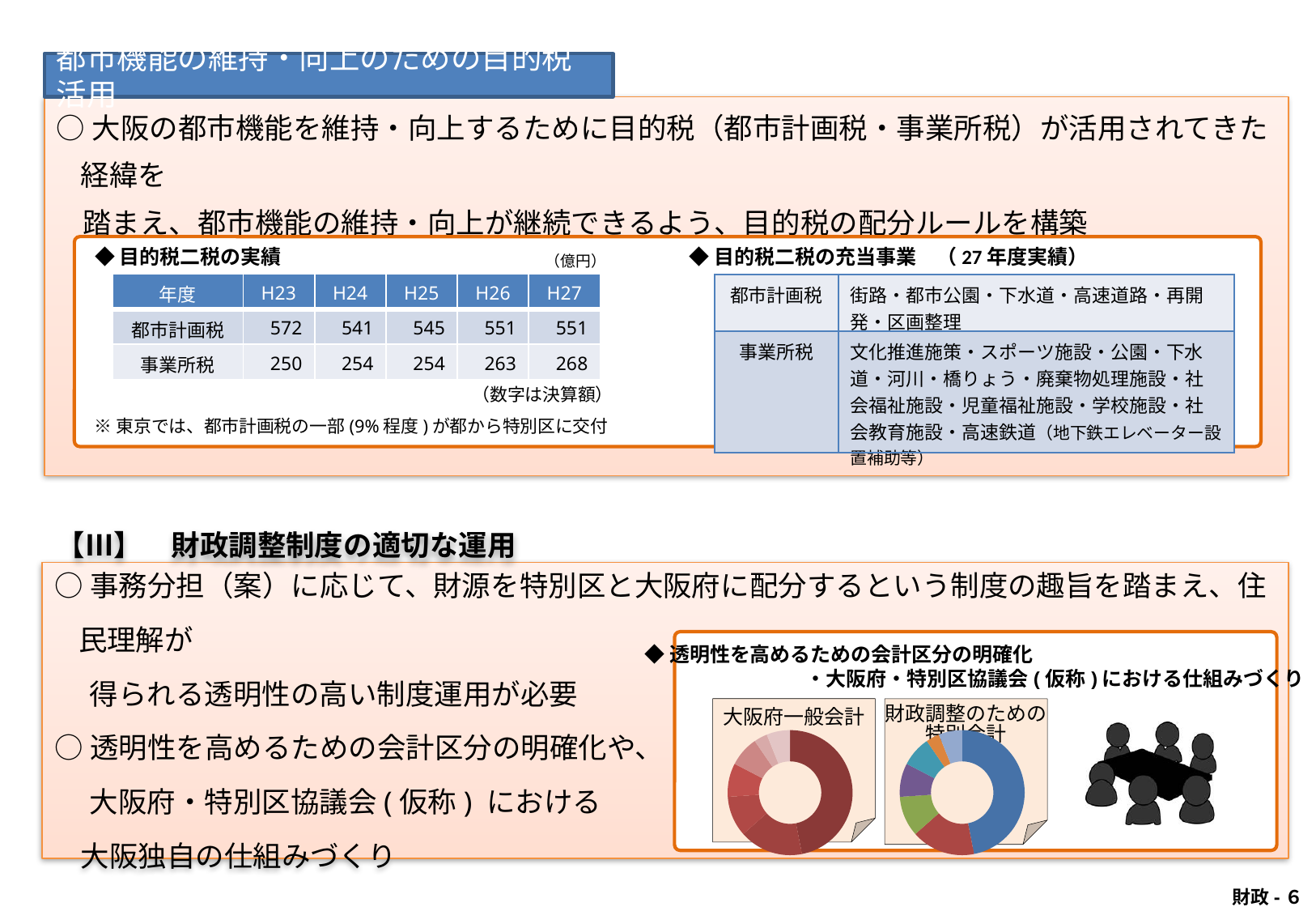
In the chart titled 大阪府一般会計, what colour is the largest slice? Dark red What kind of chart is the chart titled 大阪府一般会計? Donut chart What kind of chart is the chart titled 財政調整のための特別会計? Donut chart How many donut charts are shown on the slide? 2 What is the title of the right donut chart on the slide? 財政調整のための特別会計 What is the title of the left donut chart on the slide? 大阪府一般会計 In the chart titled 財政調整のための特別会計, what colour is the largest slice? Blue